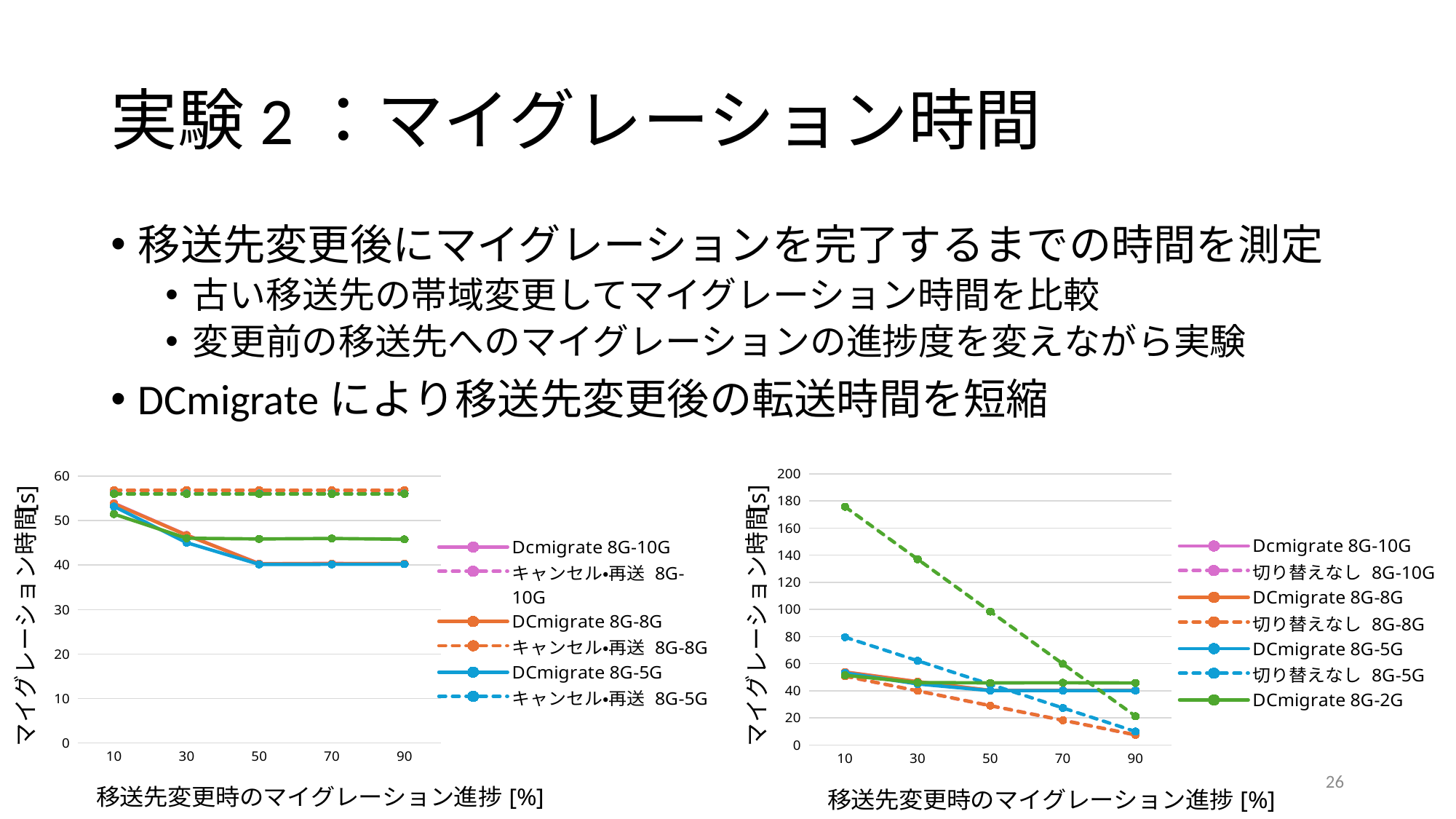
How many series does the legend of the right chart list? 7 In the left chart, is the value for キャンセル•再送 8G-8G at 10 greater or less than 50? greater In the left chart, is the value for DCmigrate 8G-5G at 90 greater or less than 50? less In the right chart, do the values for 切り替えなし 8G-8G rise or fall as the x axis increases from 10 to 90? fall What is the x-axis title of the right chart? 移送先変更時のマイグレーション進捗 [%] What kind of chart is the left chart on the slide? line chart In the right chart, is the value for 切り替えなし 8G-5G at 10 greater or less than 60? greater In the left chart, at 90, which is larger: キャンセル•再送 8G-5G or DCmigrate 8G-5G? キャンセル•再送 8G-5G In the left chart, how many points are plotted along the x axis for each series? 5 How many series does the legend of the left chart list? 6 In the right chart, at 10, which is larger: 切り替えなし 8G-5G or DCmigrate 8G-5G? 切り替えなし 8G-5G